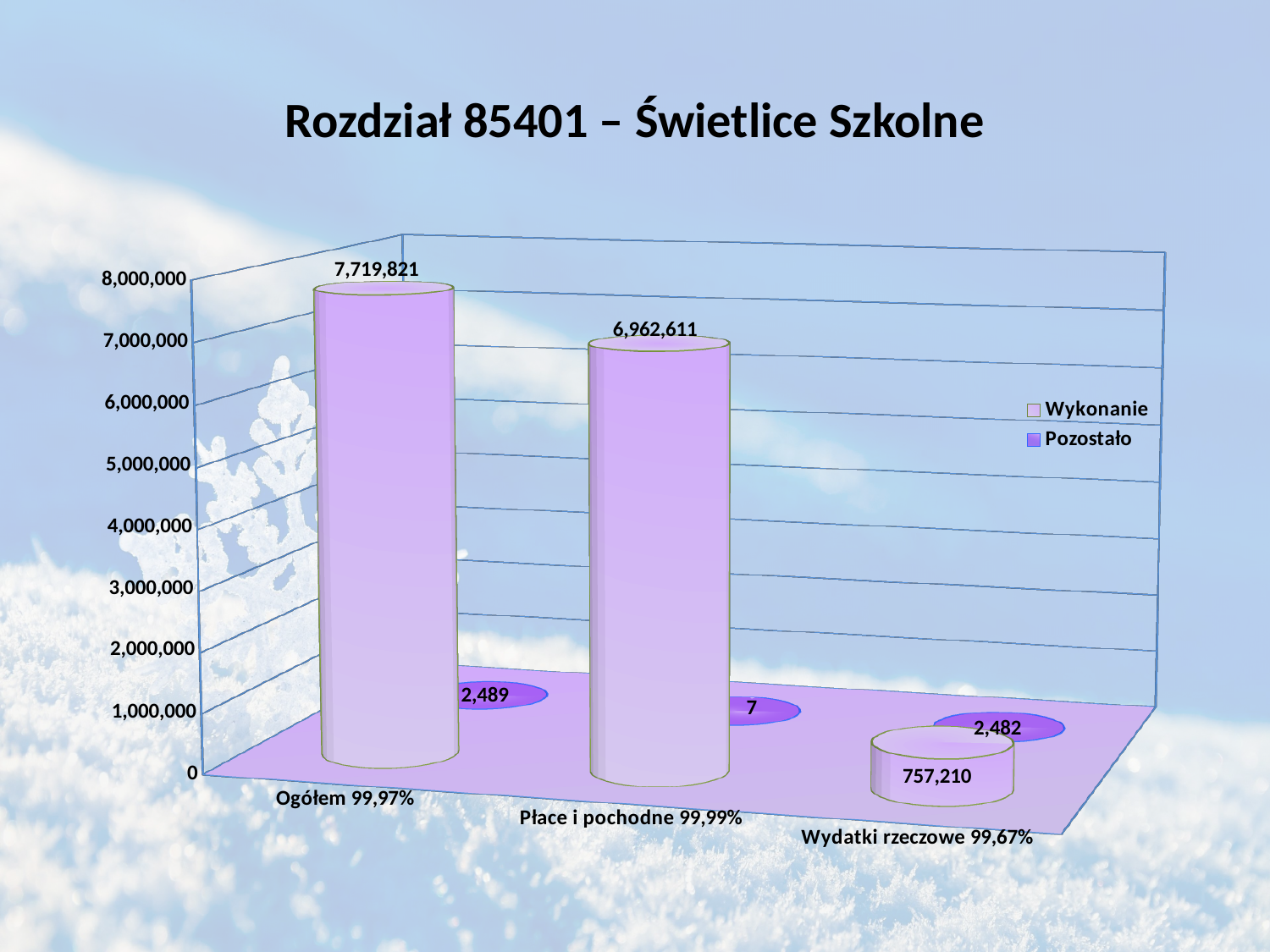
What is the Wykonanie value for Wydatki rzeczowe 99,67%? 757,210 How many categories are shown on the x axis? 3 What is the Wykonanie value for Płace i pochodne 99,99%? 6,962,611 Which category has the lowest Pozostało value? Płace i pochodne 99,99% What is the title of the chart? Rozdział 85401 – Świetlice Szkolne What is the Pozostało value for Ogółem 99,97%? 2,489 What is the Pozostało value for Wydatki rzeczowe 99,67%? 2,482 What is the difference between the Wykonanie values for Ogółem 99,97% and Płace i pochodne 99,99%? 757,210 How many series does the legend list? 2 What is the Pozostało value for Płace i pochodne 99,99%? 7 Which category has the highest Wykonanie value? Ogółem 99,97% What is the Wykonanie value for Ogółem 99,97%? 7,719,821